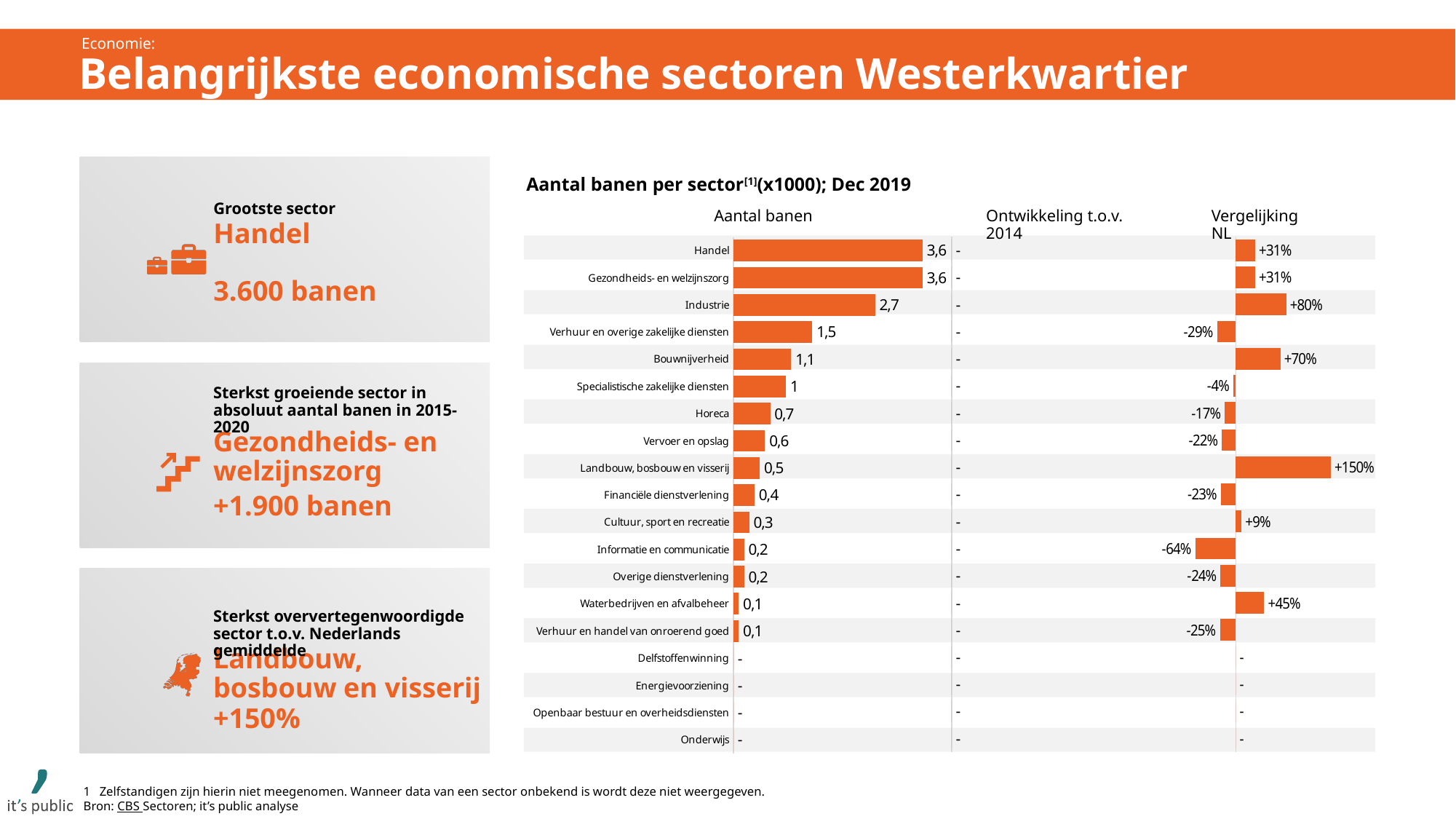
In the 'Vergelijking NL' chart, what is the value for Landbouw, bosbouw en visserij? +150% What kind of chart is used for the 'Aantal banen' column? Bar chart In the 'Aantal banen' chart, what is the value for Industrie? 2,7 What is the title of the chart on the slide? Aantal banen per sector (x1000); Dec 2019 In the 'Aantal banen' chart, which is larger: Horeca or Vervoer en opslag? Horeca In the 'Vergelijking NL' chart, what is the difference between Industrie and Bouwnijverheid? 10% In the 'Vergelijking NL' chart, which sector has the highest value? Landbouw, bosbouw en visserij In the 'Vergelijking NL' chart, what is the value for Informatie en communicatie? -64% In the 'Vergelijking NL' chart, which is larger: Waterbedrijven en afvalbeheer or Cultuur, sport en recreatie? Waterbedrijven en afvalbeheer In the 'Aantal banen' chart, what is the value for Bouwnijverheid? 1,1 In the 'Vergelijking NL' chart, which sector has the lowest value? Informatie en communicatie In the 'Aantal banen' chart, what is the difference between Industrie and Verhuur en overige zakelijke diensten? 1,2